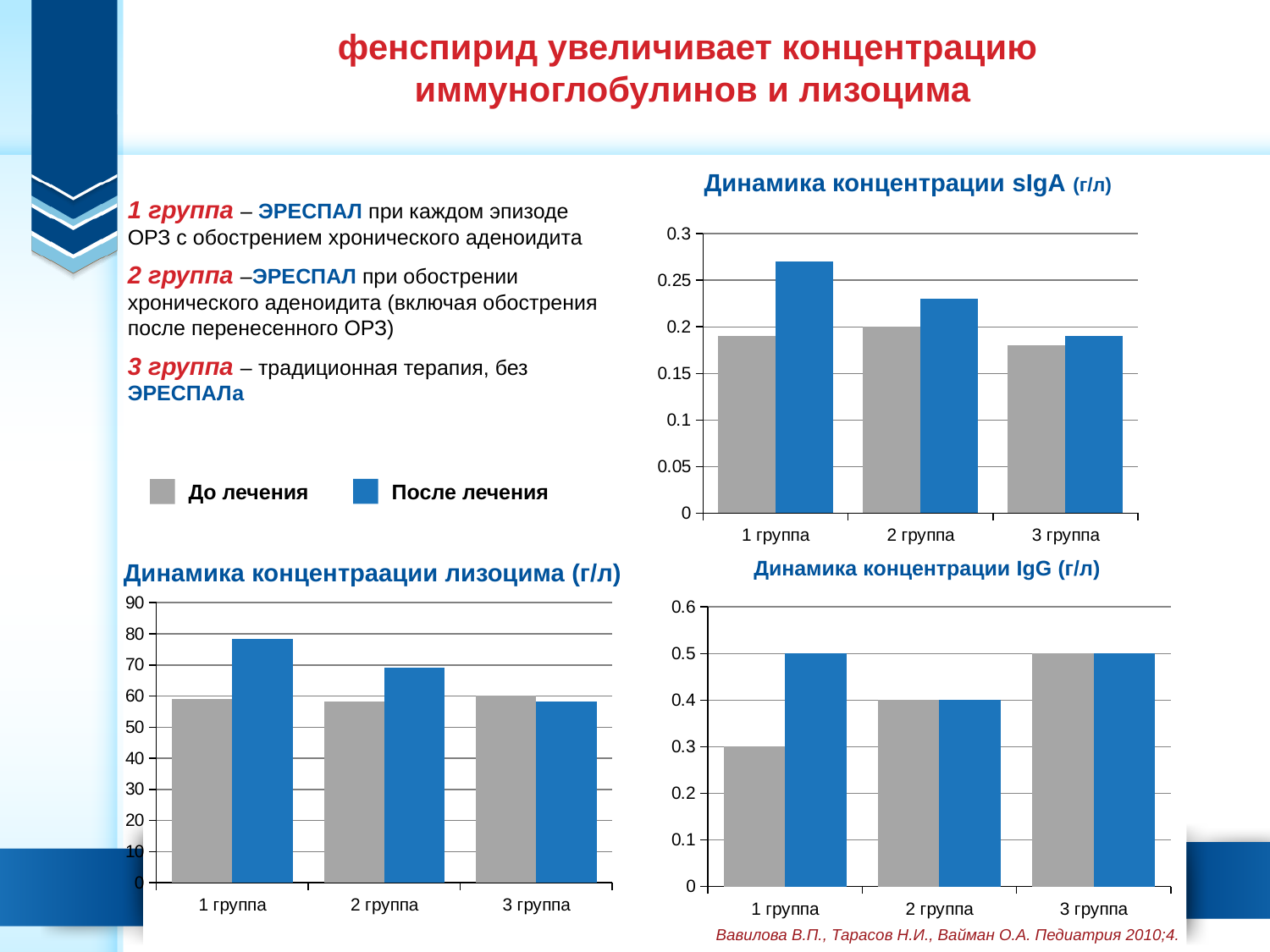
In the 'Динамика концентрации IgG (г/л)' chart, what is the value for 1 группа after treatment (После лечения)? 0.5 In the 'Динамика концентрации sIgA (г/л)' chart, what is the value for 2 группа before treatment (До лечения)? 0.2 In the 'Динамика концентрации IgG (г/л)' chart, what is the value for 2 группа before treatment (До лечения)? 0.4 In the 'Динамика концентрации sIgA (г/л)' chart, is the value for 1 группа after treatment greater or less than 0.25? greater How many groups are shown on the x axis of the 'Динамика концентрации sIgA (г/л)' chart? 3 In the 'Динамика концентрации IgG (г/л)' chart, what is the difference between the after-treatment and before-treatment values for 1 группа? 0.2 In the 'Динамика концентрации sIgA (г/л)' chart, which group has the highest after-treatment (После лечения) value? 1 группа How many series does the legend on the slide list? 2 In the 'Динамика концентраации лизоцима (г/л)' chart, is the value for 1 группа after treatment greater or less than 70? greater Which colour represents 'После лечения' in the legend? blue What kind of chart is the 'Динамика концентрации sIgA (г/л)' chart? bar chart